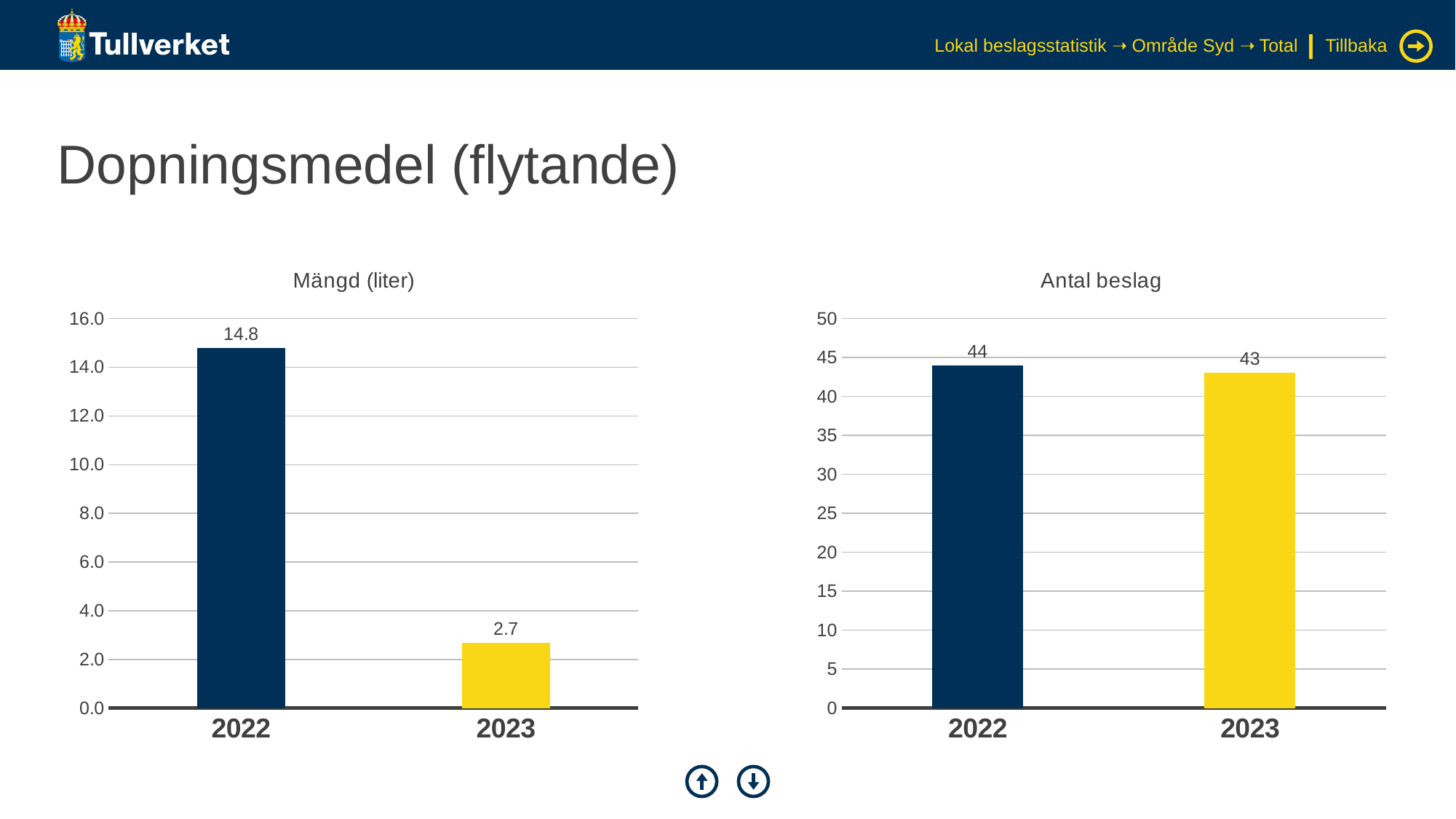
In the 'Antal beslag' chart, what is the value for 2023? 43 How many categories are shown on the x axis of the 'Antal beslag' chart? 2 In the 'Antal beslag' chart, what is the difference between the 2022 and 2023 values? 1 In the 'Antal beslag' chart, is the value for 2023 greater or less than 40? greater In the 'Mängd (liter)' chart, what is the difference between the 2022 and 2023 values? 12.1 What kind of chart is the 'Mängd (liter)' chart? bar chart In the 'Antal beslag' chart, what is the value for 2022? 44 In the 'Mängd (liter)' chart, what is the value for 2023? 2.7 In the 'Mängd (liter)' chart, which year has the highest value? 2022 In the 'Mängd (liter)' chart, is the value for 2022 greater or less than 10.0? greater In the 'Mängd (liter)' chart, what is the value for 2022? 14.8 In the 'Mängd (liter)' chart, do the values rise or fall from 2022 to 2023? fall